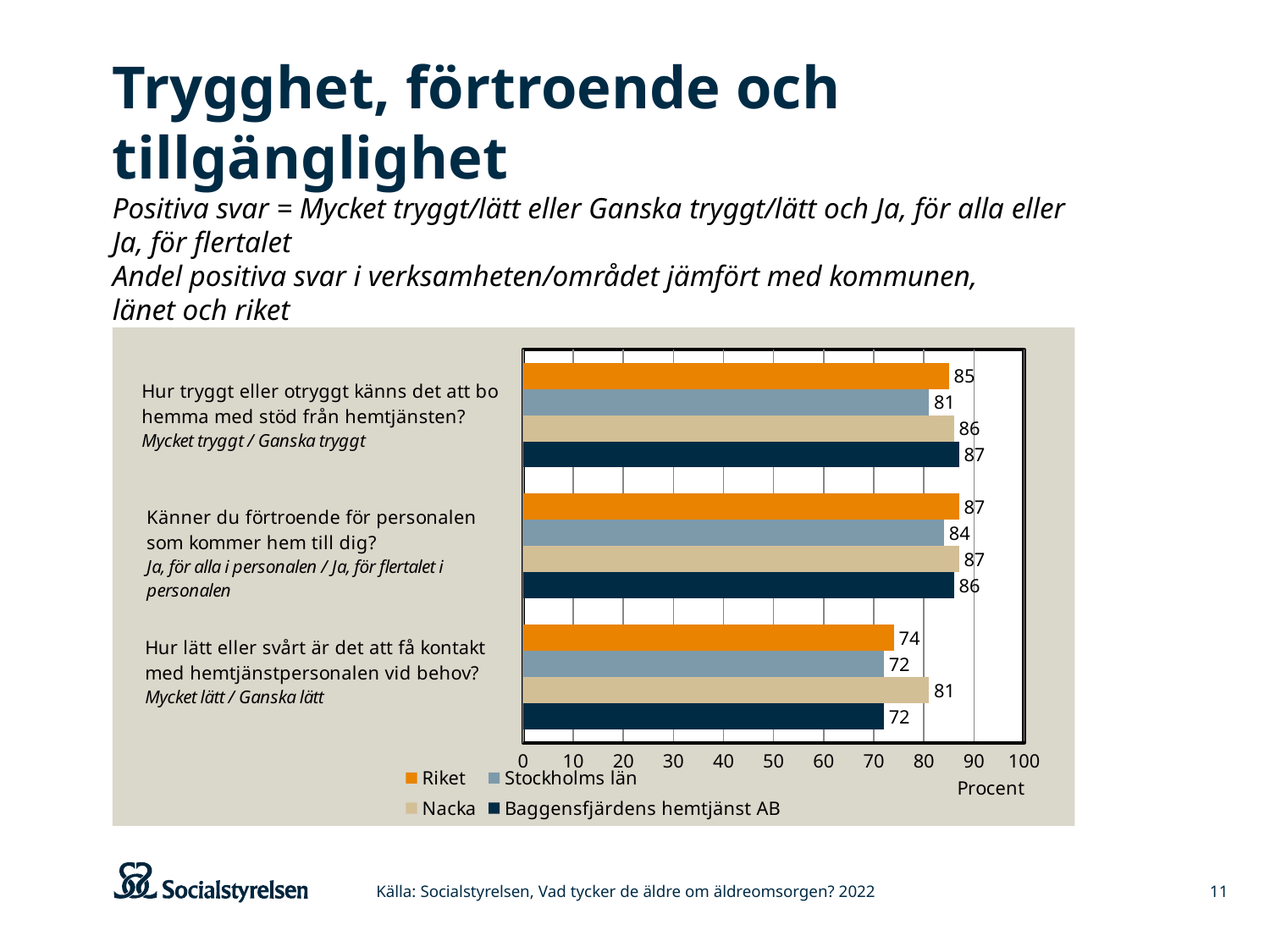
What is the value for Baggensfjärdens hemtjänst AB on the question 'Hur lätt eller svårt är det att få kontakt med hemtjänstpersonalen vid behov?' 72 What is the value for Riket on the question 'Hur tryggt eller otryggt känns det att bo hemma med stöd från hemtjänsten?' 85 What is the value for Stockholms län on the question 'Känner du förtroende för personalen som kommer hem till dig?' 84 How many question categories are shown on the chart? 3 Is the value for Riket on the question 'Hur lätt eller svårt är det att få kontakt med hemtjänstpersonalen vid behov?' greater or less than 80? less What is the difference between Nacka and Riket on the question 'Hur lätt eller svårt är det att få kontakt med hemtjänstpersonalen vid behov?' 7 Which is larger on the question 'Hur tryggt eller otryggt känns det att bo hemma med stöd från hemtjänsten?': Baggensfjärdens hemtjänst AB or Stockholms län? Baggensfjärdens hemtjänst AB Which series has the highest value on the question 'Hur lätt eller svårt är det att få kontakt med hemtjänstpersonalen vid behov?' Nacka What unit is labelled on the x axis of the chart? Procent How many series does the legend list? 4 Which series has the lowest value on the question 'Hur tryggt eller otryggt känns det att bo hemma med stöd från hemtjänsten?' Stockholms län What kind of chart is shown on the slide? Bar chart